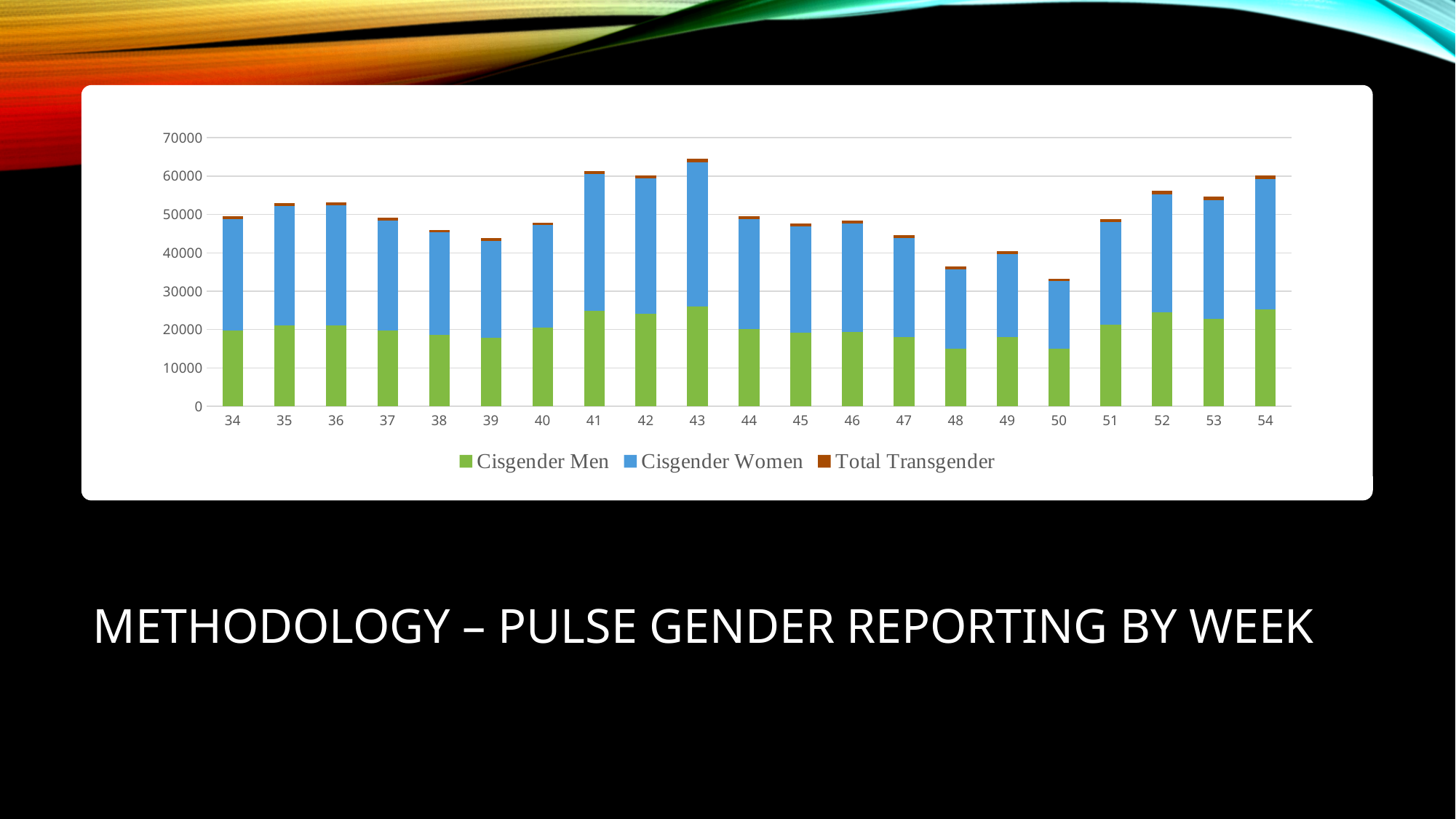
Which week has the larger total bar, week 41 or week 44? 41 How many weeks are shown on the x axis of the chart? 21 How many series does the chart's legend list? 3 Is the Cisgender Men value for week 48 greater or less than 20000? less Which week has the larger Cisgender Men value, week 43 or week 48? 43 Which week has the lowest total bar? 50 Is the total bar for week 43 greater or less than 60000? greater Do the total bars rise or fall from week 43 to week 50? fall Which series is shown in green in the chart? Cisgender Men What kind of chart is shown on the slide? Stacked bar chart Which week has the highest total bar? 43 Is the total bar for week 50 greater or less than 40000? less